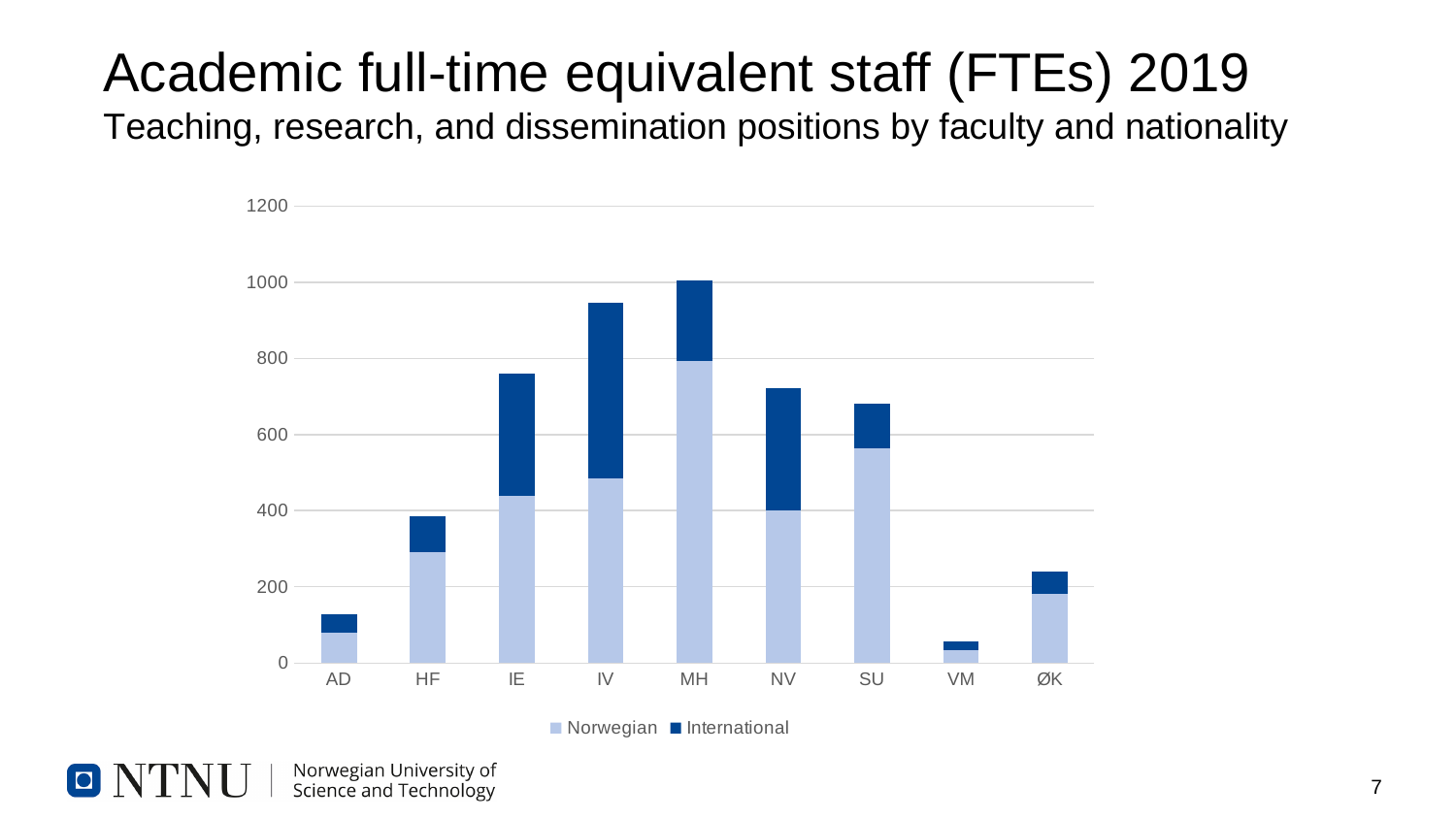
Is the Norwegian value for MH greater or less than 600? greater How many series does the chart's legend list? 2 Which faculty has the highest total number of academic FTEs? MH Is the total value for VM greater or less than 200? less How many faculties are shown on the x axis of the chart? 9 Is the total value for IV greater or less than 800? greater What are the two series named in the chart's legend? Norwegian and International Which faculty has a larger total of academic FTEs, IE or SU? IE What kind of chart is shown on the slide? Stacked bar chart Which faculty has a larger total of academic FTEs, HF or ØK? HF Which faculty has the lowest total number of academic FTEs? VM